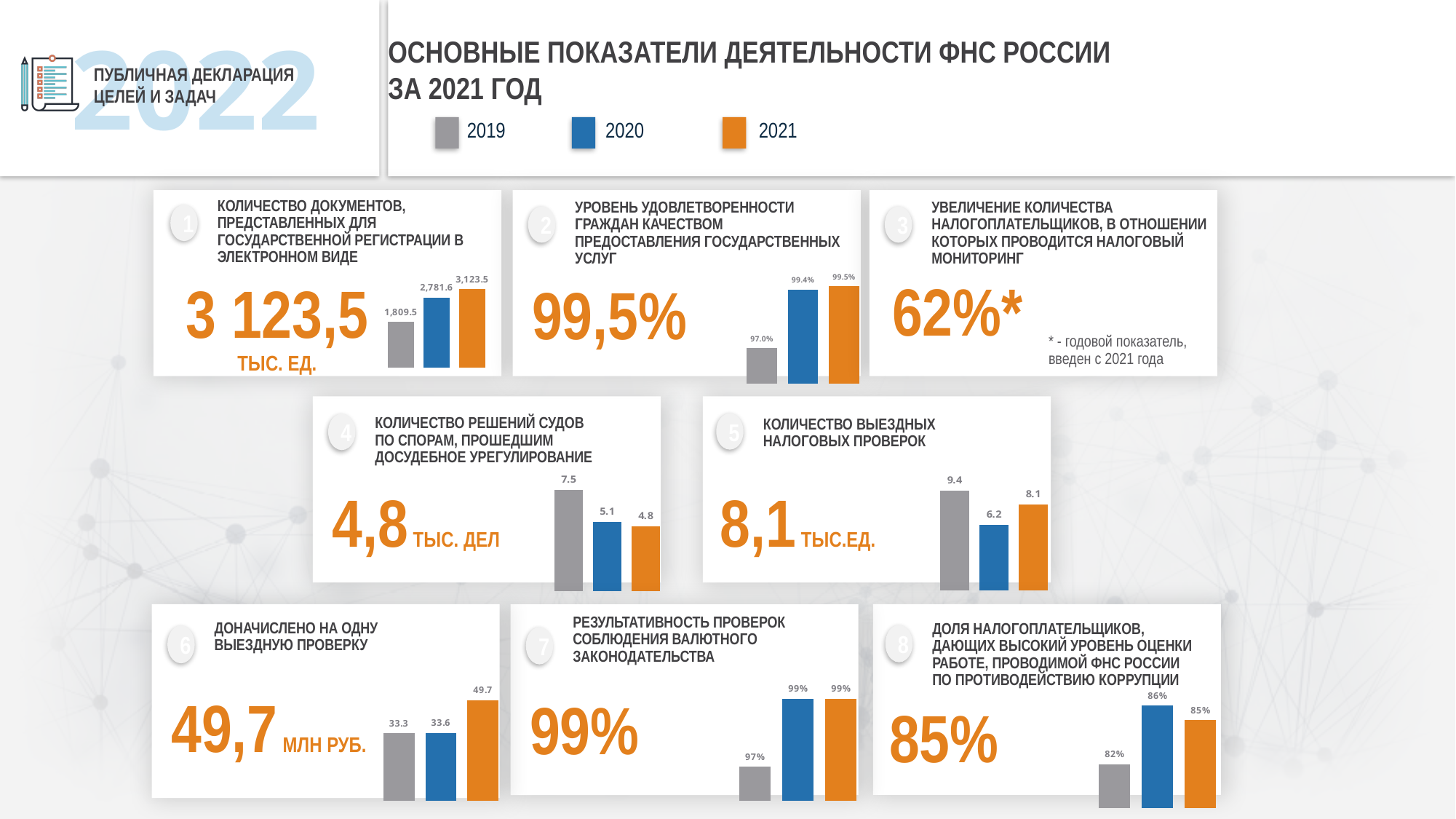
In chart 5 (Количество выездных налоговых проверок), what is the difference between the 2019 and 2021 values? 1.3 In chart 1 (Количество документов, представленных для государственной регистрации в электронном виде), what is the value for 2019? 1,809.5 In chart 6 (Доначислено на одну выездную проверку), which is larger, the value for 2021 or the value for 2019? 2021 In chart 5 (Количество выездных налоговых проверок), which year has the lowest value? 2020 In chart 4 (Количество решений судов по спорам, прошедшим досудебное урегулирование), do the values rise or fall from 2019 to 2021? fall In chart 8 (Доля налогоплательщиков, дающих высокий уровень оценки работе, проводимой ФНС России по противодействию коррупции), which year has the highest value? 2020 In chart 1 (Количество документов, представленных для государственной регистрации в электронном виде), what is the difference between the 2021 and 2020 values? 341.9 In chart 7 (Результативность проверок соблюдения валютного законодательства), what is the value for 2019? 97% In chart 2 (Уровень удовлетворенности граждан качеством предоставления государственных услуг), what is the value for 2020? 99.4% In chart 4 (Количество решений судов по спорам, прошедшим досудебное урегулирование), which year has the highest value? 2019 How many years does the legend at the top of the slide list? 3 In chart 6 (Доначислено на одну выездную проверку), what is the value for 2020? 33.6